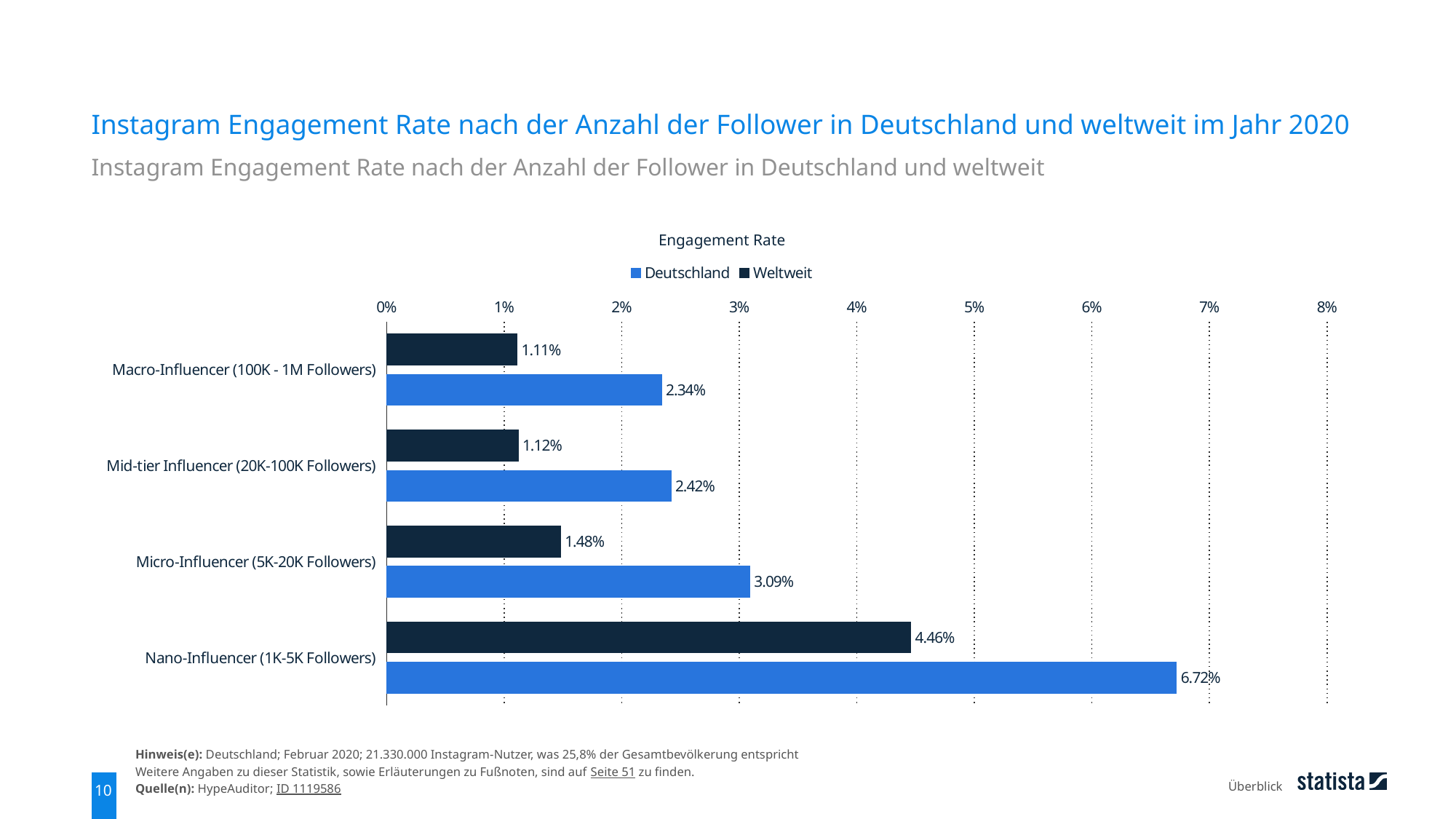
What is the Weltweit engagement rate for Macro-Influencer (100K - 1M Followers)? 1.11% Is the Weltweit engagement rate for Nano-Influencer (1K-5K Followers) greater or less than 4%? greater Which influencer category has the lowest Deutschland engagement rate? Macro-Influencer (100K - 1M Followers) How many influencer categories are shown in the chart? 4 Which influencer category has the highest Deutschland engagement rate? Nano-Influencer (1K-5K Followers) What is the Weltweit engagement rate for Micro-Influencer (5K-20K Followers)? 1.48% What is the Deutschland engagement rate for Nano-Influencer (1K-5K Followers)? 6.72% Which is larger for Micro-Influencer (5K-20K Followers): the Deutschland or the Weltweit engagement rate? Deutschland What is the difference between the Deutschland and Weltweit engagement rates for Nano-Influencer (1K-5K Followers)? 2.26% How many series does the legend list? 2 What kind of chart is shown on the slide? Bar chart What is the Deutschland engagement rate for Mid-tier Influencer (20K-100K Followers)? 2.42%